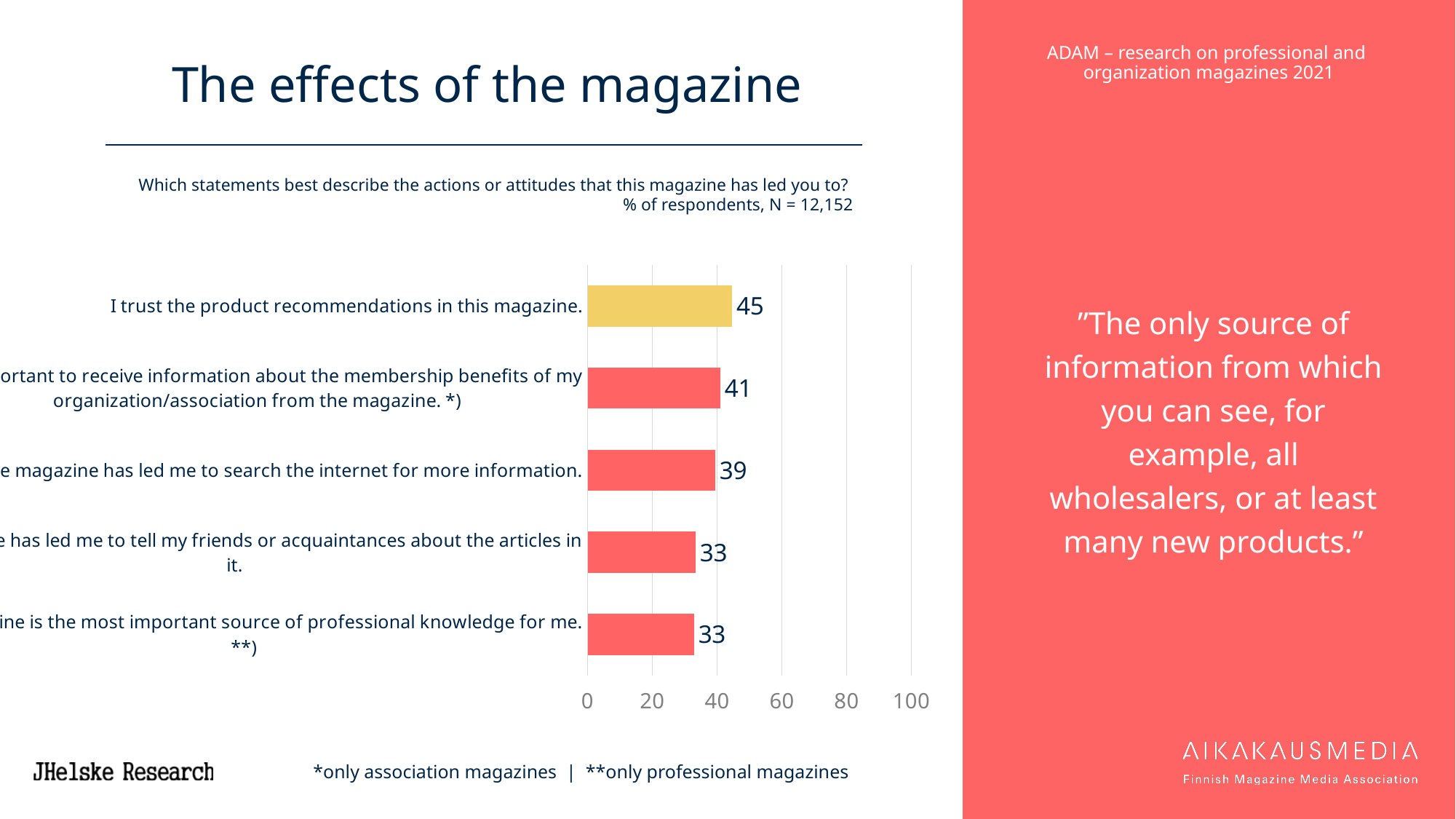
What kind of chart is shown on the slide? bar chart Which statement has the highest value in the chart? I trust the product recommendations in this magazine. How many statements (bars) are plotted in the chart? 5 Which bar is coloured differently (yellow) from the others? I trust the product recommendations in this magazine. What is the lowest value shown in the chart? 33 Is the value for the statement about the magazine being the most important source of professional knowledge greater or less than 40? less What percentage of respondents said they trust the product recommendations in this magazine? 45 What is the value for the statement about receiving information about the membership benefits of my organization/association from the magazine? 41 What is the value for the statement that the magazine has led me to tell my friends or acquaintances about the articles in it? 33 What is the difference between the value for trusting product recommendations and the value for searching the internet for more information? 6 What is the value for the statement that the magazine has led me to search the internet for more information? 39 Which is larger: the value for receiving information about membership benefits or the value for telling friends about the articles? receiving information about membership benefits